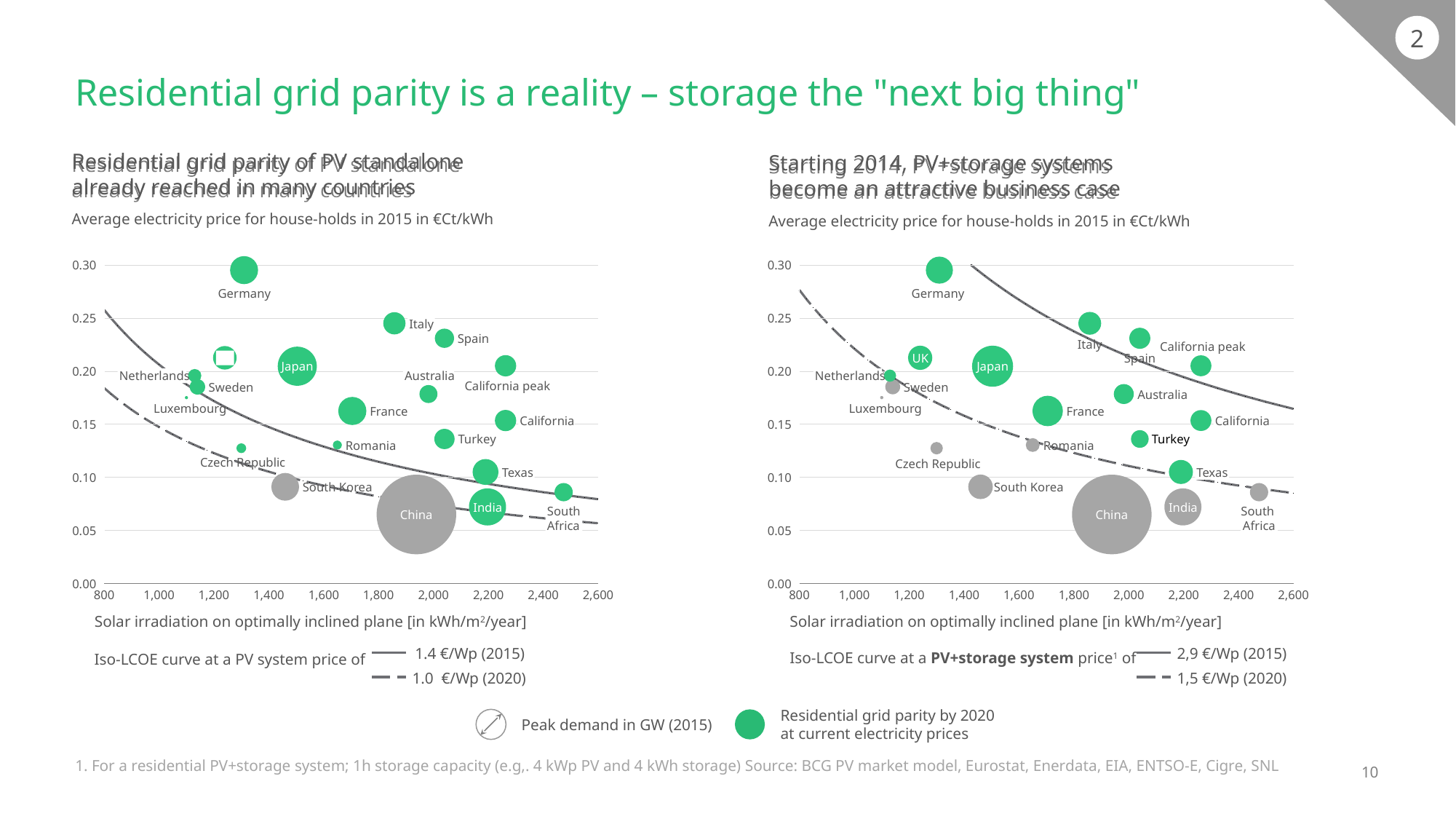
In the right chart, is the value for Spain greater or less than 0.20? greater In the right chart, which has the higher electricity price, Australia or France? Australia In the left chart, is the value for Texas greater or less than 0.15? less In the right chart (PV+storage), which country has the highest average electricity price? Germany In the right chart, is the value for Czech Republic greater or less than 0.15? less In the left chart, do the iso-LCOE curves rise or fall as solar irradiation increases along the x axis? fall In the left chart (PV standalone), which country has the highest average electricity price? Germany What kind of chart is shown on the left side of the slide? Bubble chart In the left chart, which has the higher electricity price, Italy or Spain? Italy In the right chart, what PV+storage system price does the solid iso-LCOE curve represent? 2,9 €/Wp (2015) In the left chart, which country has the largest bubble (highest peak demand in GW)? China